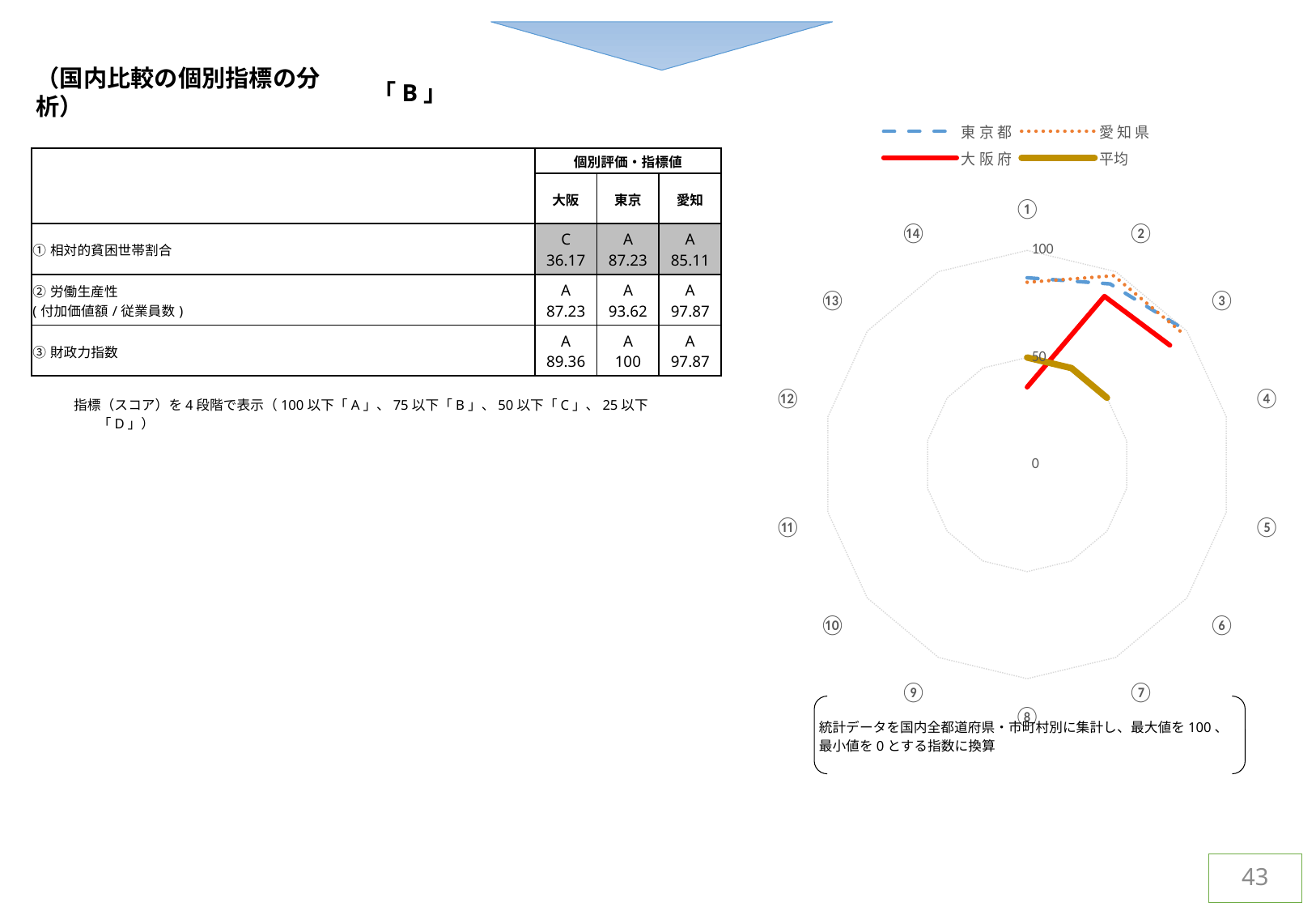
In the radar chart, which is larger at category ③: 大阪府 or 平均? 大阪府 In the radar chart, is the value for 東京都 at category ① greater or less than 50? greater What colour is the line for 大阪府 in the radar chart? red What is the maximum value shown on the radar chart's axis? 100 In the radar chart, which is larger at category ①: 東京都 or 大阪府? 東京都 What kind of chart is shown on the right of the slide? radar chart In the radar chart, is the value for 大阪府 at category ① greater or less than 50? less In the radar chart, which series has the lowest value at category ①? 大阪府 In the radar chart, is the value for 大阪府 at category ③ greater or less than 50? greater How many numbered categories are arranged around the radar chart? 14 How many series does the legend of the radar chart list? 4